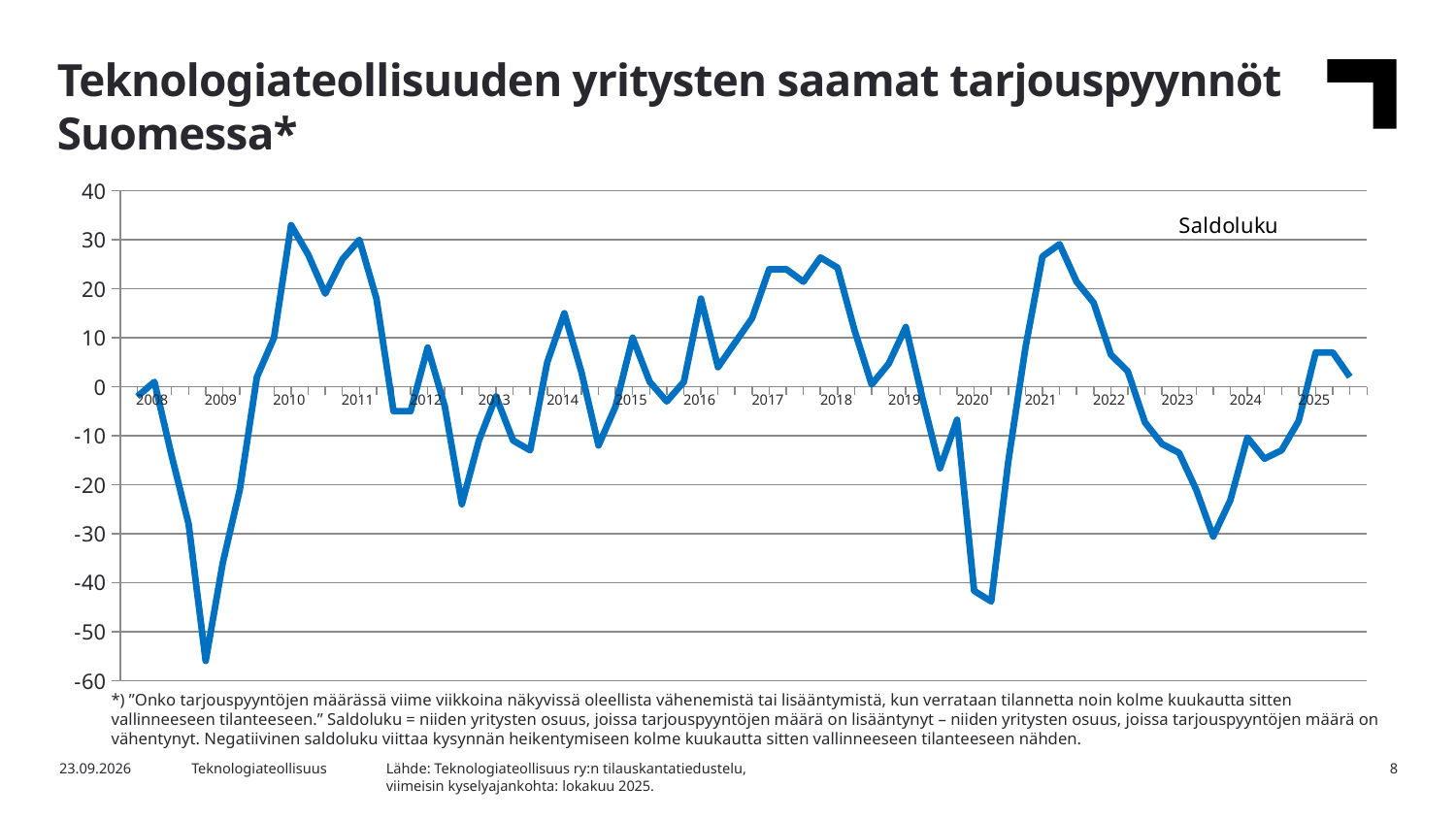
Which low point is lower: the one in 2009 or the one in 2020? 2009 In which year does the line reach its lowest value? 2009 Is the low point of the line in 2020 greater or less than -40? less In which year does the line reach its highest value? 2010 What is the title of the chart on the slide? Saldoluku Is the peak value of the line in 2010 greater or less than 30? greater What kind of chart is shown on the slide? line chart Do the values rise or fall between the peak in 2021 and the low in 2023? fall How many years are labelled on the x axis? 18 Is the lowest value of the line, reached in 2009, greater or less than -50? less